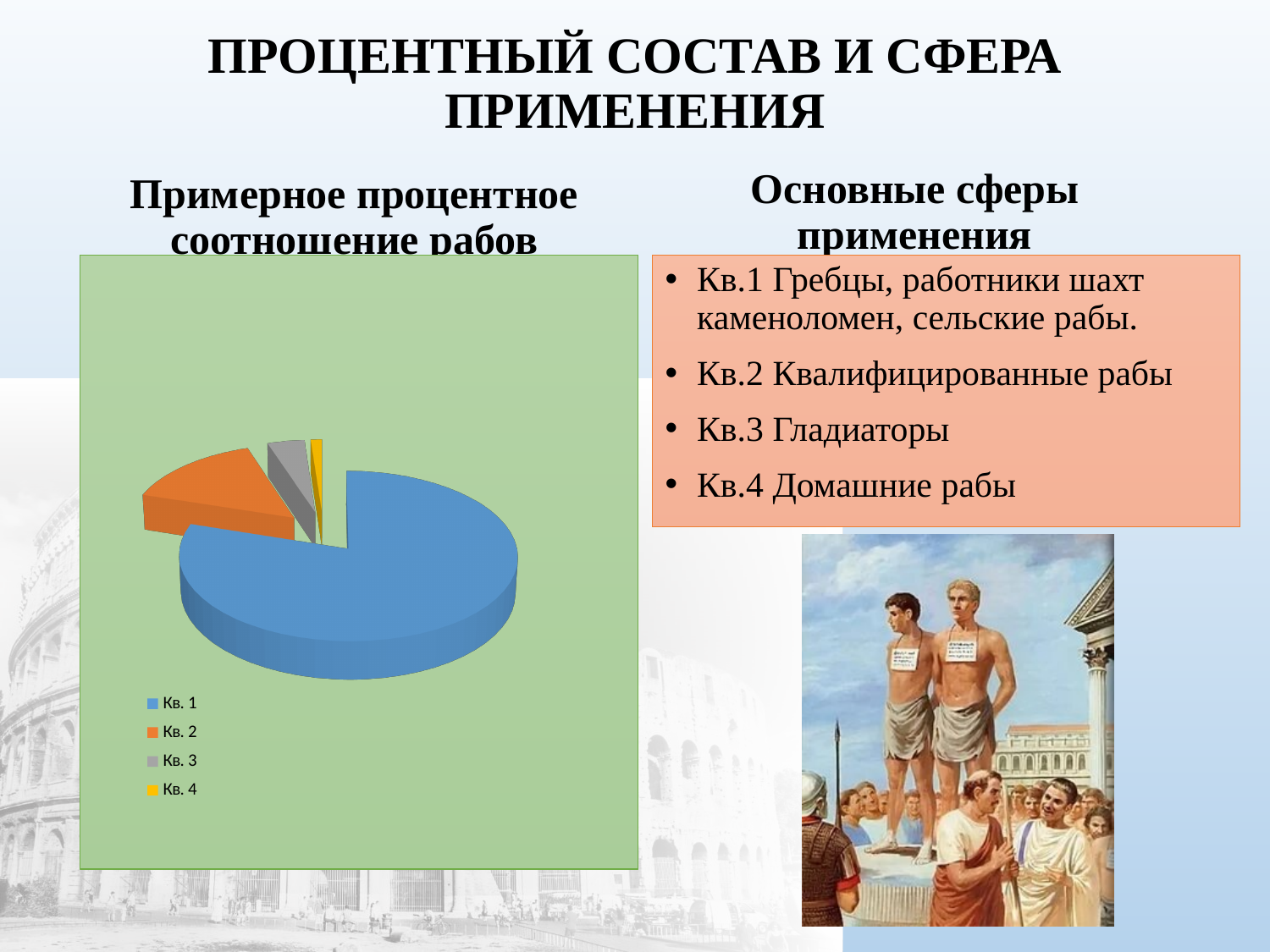
Which slice is larger in the pie chart, Кв. 1 or Кв. 2? Кв. 1 Which category has the largest slice in the pie chart? Кв. 1 What kind of chart is shown on the slide? pie chart How many entries does the legend of the pie chart list? 4 Which category has the smallest slice in the pie chart? Кв. 4 Which slice is larger in the pie chart, Кв. 2 or Кв. 3? Кв. 2 Which slice is larger in the pie chart, Кв. 4 or Кв. 2? Кв. 2 What colour is the Кв. 1 slice in the pie chart? blue How many slices does the pie chart have? 4 What colour is the Кв. 2 slice in the pie chart? orange